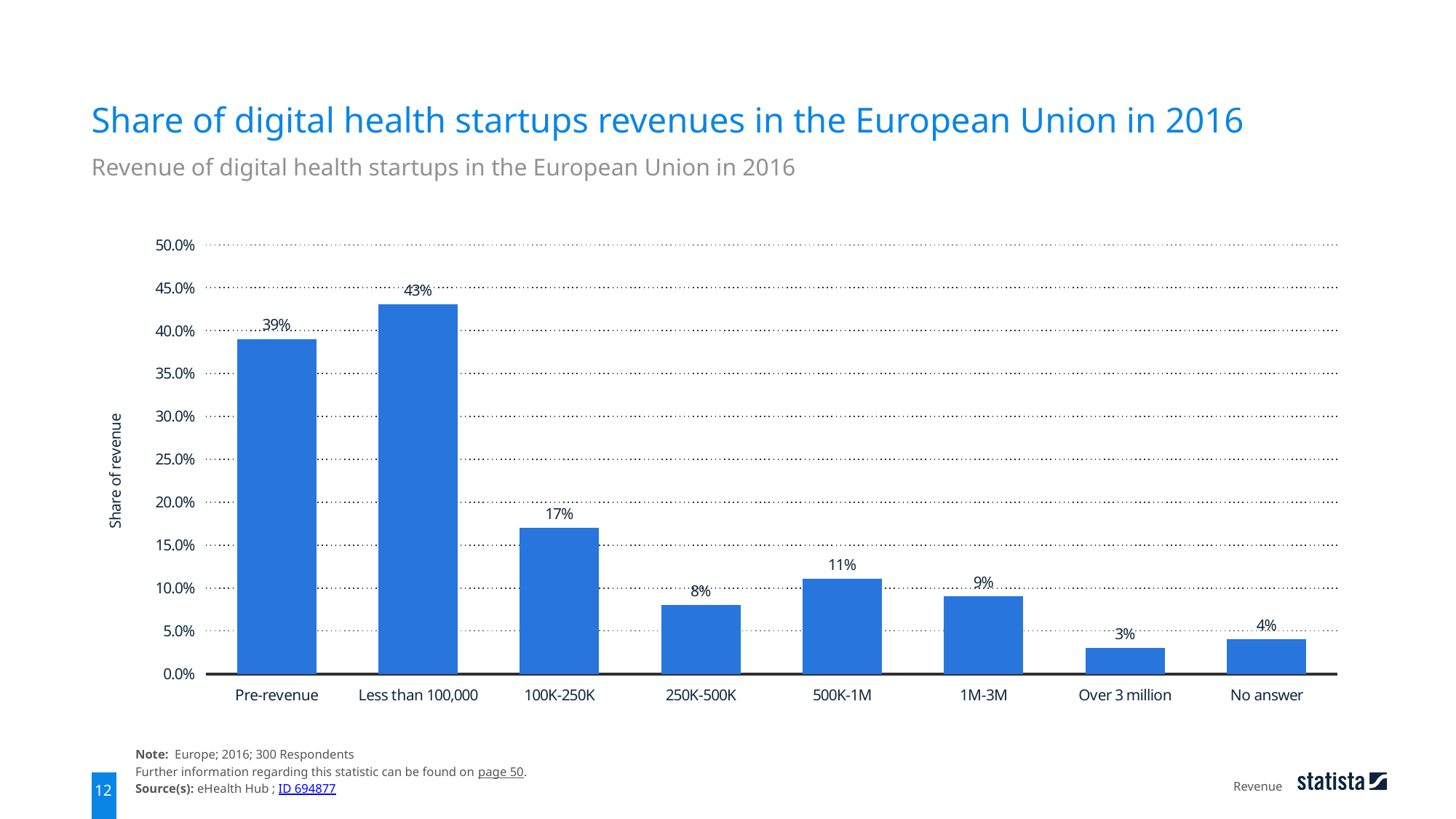
What is the share of revenue for the No answer category? 4% What is the difference between the shares for Less than 100,000 and Pre-revenue? 4% What is the difference between the shares for 100K-250K and 250K-500K? 9% Is the value for 100K-250K greater or less than 20.0%? less How many categories are shown on the x axis? 8 Which category has the lowest share of revenue? Over 3 million Which category has the highest share of revenue? Less than 100,000 What is the label of the y axis? Share of revenue Which is larger, the share for 500K-1M or the share for 1M-3M? 500K-1M What kind of chart is shown on the slide? Bar chart What is the share of revenue for the Pre-revenue category? 39% What is the share of revenue for the 500K-1M category? 11%